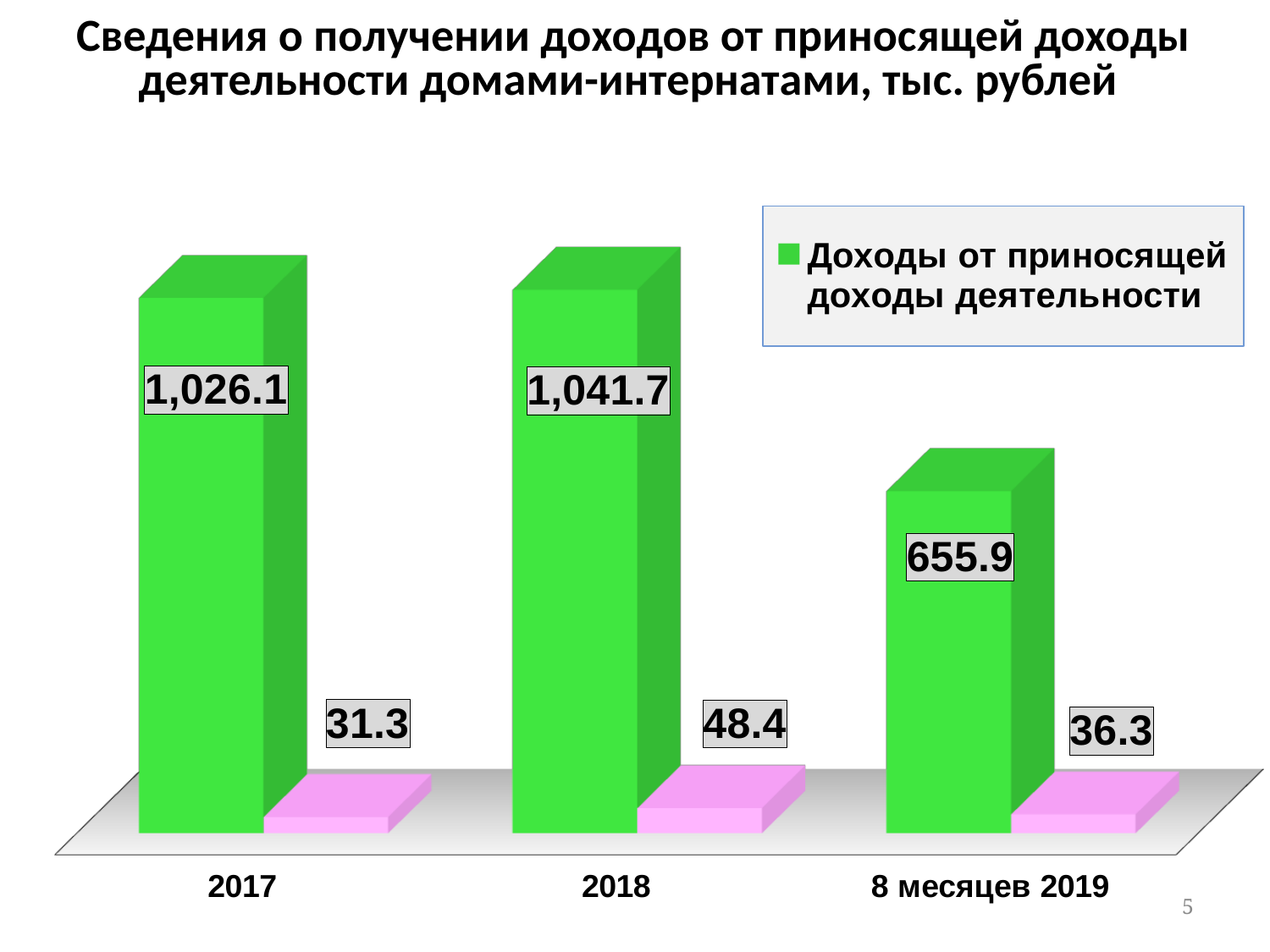
What is the difference between the green series values for 2018 and 2017? 15.6 Which category has the lowest value for the pink bars? 2017 What is the value of the green series (Доходы от приносящей доходы деятельности) for 2017? 1,026.1 Which is larger for the pink bars: 2018 or 8 месяцев 2019? 2018 What is the value of the pink bar for 2018? 48.4 What is the value of the green series for 8 месяцев 2019? 655.9 What kind of chart is shown on the slide? Bar chart Which category has the lowest value for the green series? 8 месяцев 2019 What is the value of the pink bar for 8 месяцев 2019? 36.3 How many categories are shown on the x axis? 3 Which category has the highest value for the green series? 2018 What is the value of the green series for 2018? 1,041.7